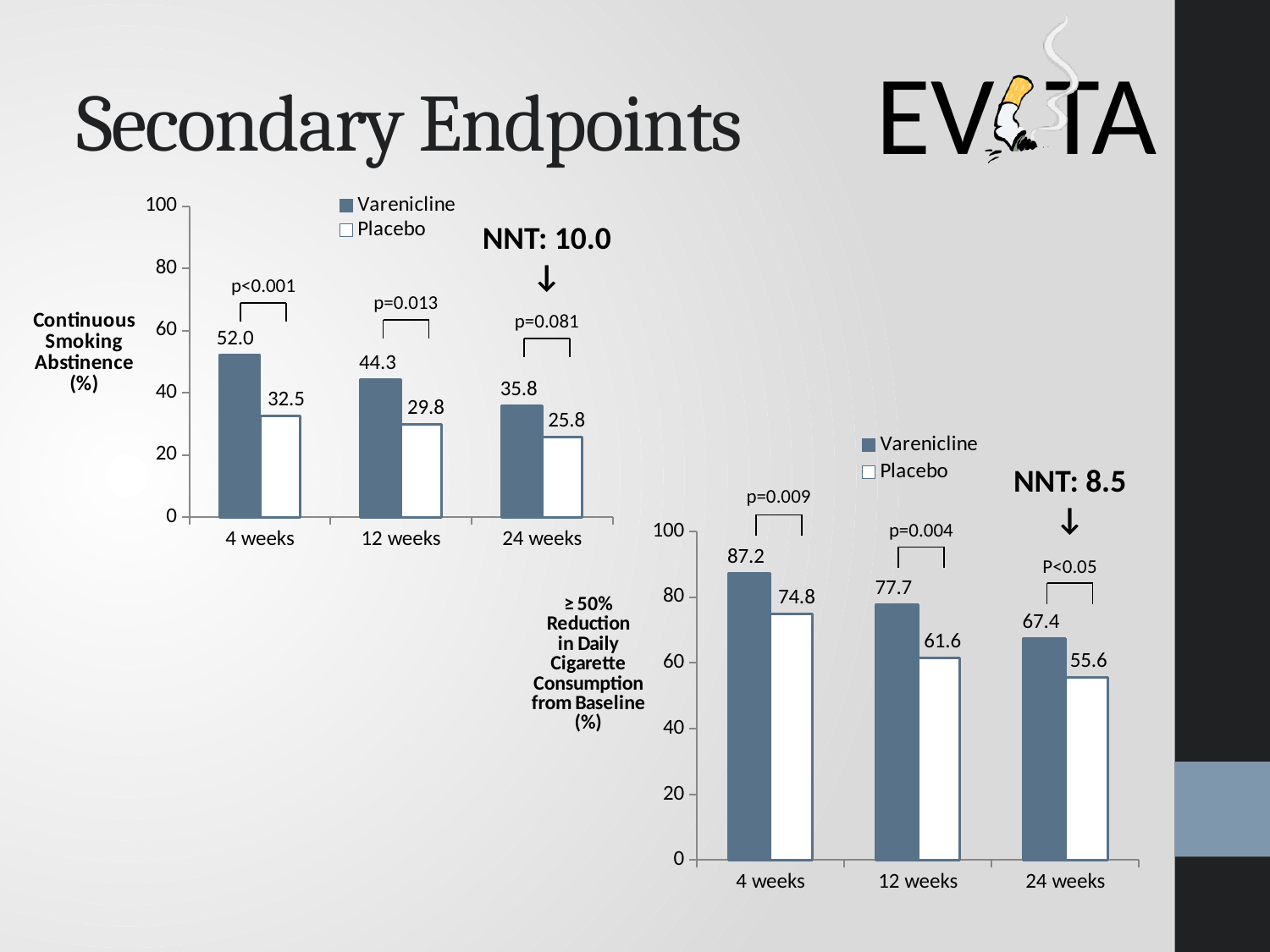
In the Continuous Smoking Abstinence chart, do the Placebo values rise or fall from 4 weeks to 24 weeks? fall How many series does the legend of the Continuous Smoking Abstinence chart list? 2 In the Continuous Smoking Abstinence chart, what is the value for Placebo at 24 weeks? 25.8 In the ≥ 50% Reduction in Daily Cigarette Consumption chart, what is the difference between Varenicline and Placebo at 24 weeks? 11.8 In the ≥ 50% Reduction in Daily Cigarette Consumption chart, which is larger at 4 weeks, Varenicline or Placebo? Varenicline In the ≥ 50% Reduction in Daily Cigarette Consumption chart, at which time point is the Placebo value highest? 4 weeks In the ≥ 50% Reduction in Daily Cigarette Consumption chart, what is the value for Varenicline at 4 weeks? 87.2 In the Continuous Smoking Abstinence chart, what is the value for Varenicline at 4 weeks? 52.0 In the ≥ 50% Reduction in Daily Cigarette Consumption chart, what is the value for Placebo at 12 weeks? 61.6 What kind of chart is the ≥ 50% Reduction in Daily Cigarette Consumption chart? bar chart In the Continuous Smoking Abstinence chart, at which time point is the Varenicline value lowest? 24 weeks In the Continuous Smoking Abstinence chart, what is the difference between Varenicline and Placebo at 12 weeks? 14.5